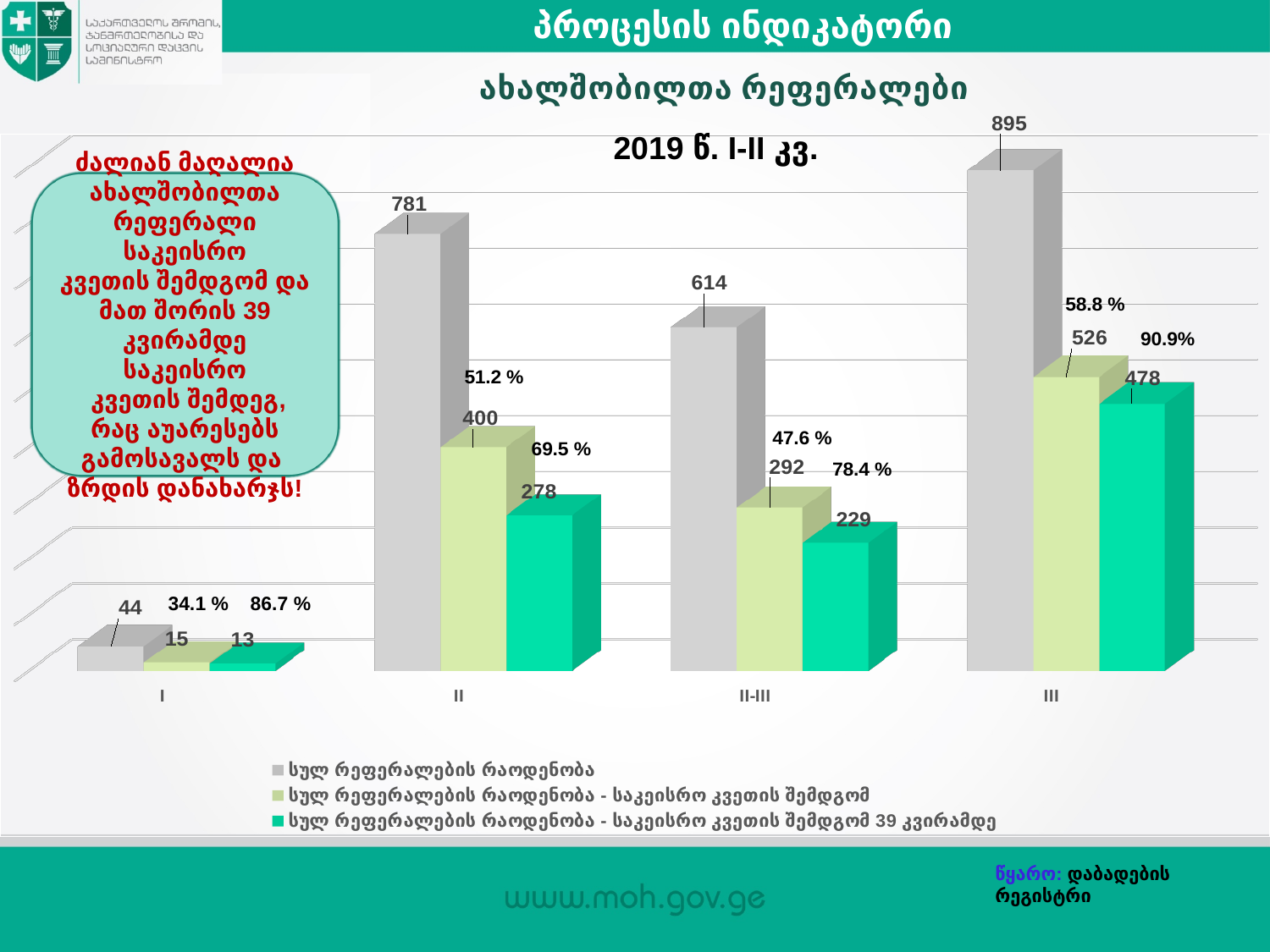
Which category has the highest value for the gray bar (სულ რეფერალების რაოდენობა)? III What is the value of the gray bar (სულ რეფერალების რაოდენობა) for category III? 895 How many series does the legend list? 3 What is the value of the light green bar (სულ რეფერალების რაოდენობა - საკეისრო კვეთის შემდგომ) for category II? 400 Which is larger: the light green bar for category II or the light green bar for category II-III? Category II (400) What is the difference between the gray bar values for categories III and II? 114 What is the value of the teal bar (საკეისრო კვეთის შემდგომ 39 კვირამდე) for category II-III? 229 How many categories are shown on the x axis? 4 What period is stated in the chart title? 2019 წ. I-II კვ. What kind of chart is shown on the slide? Bar chart What percentage label is shown next to the teal bar for category III? 90.9% Which category has the lowest value for the teal bar (საკეისრო კვეთის შემდგომ 39 კვირამდე)? I